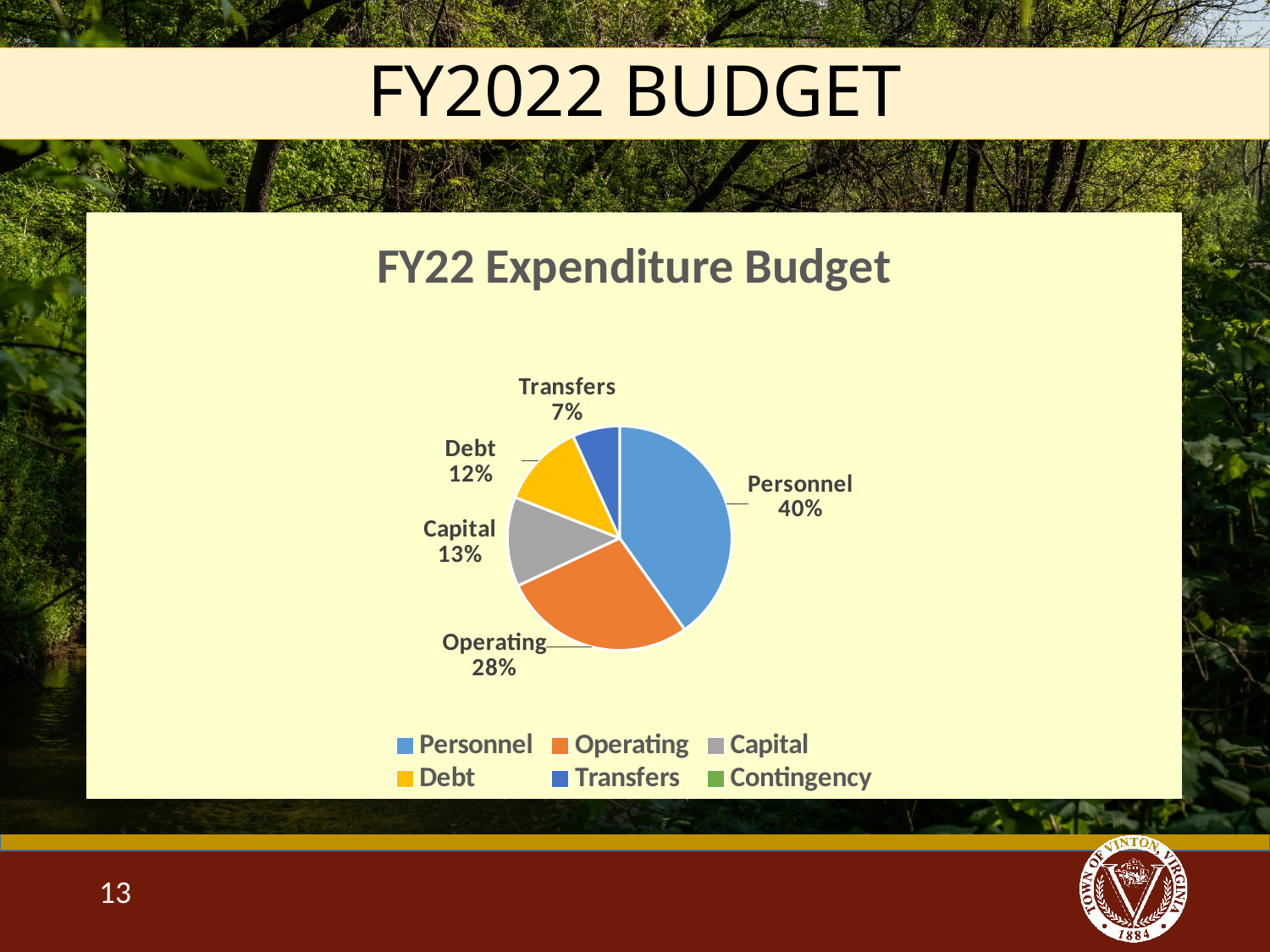
How many categories does the legend list? 6 What is the title of the chart? FY22 Expenditure Budget Which is larger, the Capital share or the Debt share? Capital What share of the FY22 Expenditure Budget is Transfers? 7% What type of chart is shown on the slide? Pie chart What share of the FY22 Expenditure Budget is Personnel? 40% Which labelled slice has the smallest share of the FY22 Expenditure Budget? Transfers Which category has the largest share of the FY22 Expenditure Budget? Personnel What share of the FY22 Expenditure Budget is Debt? 12% What share of the FY22 Expenditure Budget is Operating? 28% How many percentage points larger is the Personnel share than the Operating share? 12 What share of the FY22 Expenditure Budget is Capital? 13%